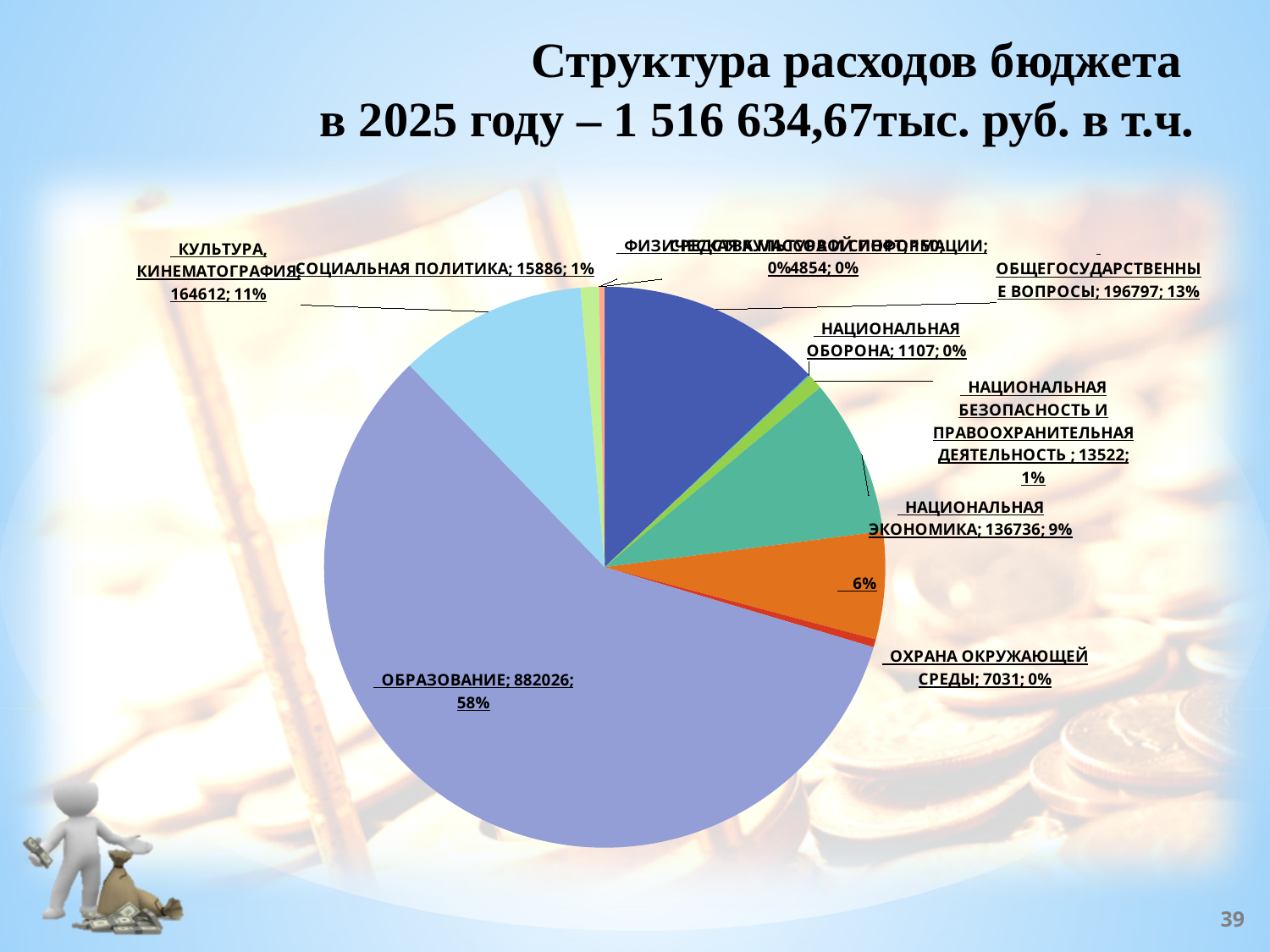
What is the value shown for НАЦИОНАЛЬНАЯ ОБОРОНА? 1107 What is the difference between the values for КУЛЬТУРА, КИНЕМАТОГРАФИЯ and НАЦИОНАЛЬНАЯ ЭКОНОМИКА? 27876 What share of the pie does ОБРАЗОВАНИЕ account for? 58% Which category has the largest slice of the pie? ОБРАЗОВАНИЕ What kind of chart is shown on the slide? Pie chart What is the value shown for ОБЩЕГОСУДАРСТВЕННЫЕ ВОПРОСЫ? 196797 What percentage of the pie is КУЛЬТУРА, КИНЕМАТОГРАФИЯ? 11% What is the difference between the values for ОБЩЕГОСУДАРСТВЕННЫЕ ВОПРОСЫ and НАЦИОНАЛЬНАЯ ЭКОНОМИКА? 60061 Which is larger, ОБЩЕГОСУДАРСТВЕННЫЕ ВОПРОСЫ or НАЦИОНАЛЬНАЯ ЭКОНОМИКА? ОБЩЕГОСУДАРСТВЕННЫЕ ВОПРОСЫ What is the value shown for НАЦИОНАЛЬНАЯ ЭКОНОМИКА? 136736 What total budget expenditure for 2025 is stated in the slide title? 1 516 634,67 тыс. руб. What is the value shown for ОБРАЗОВАНИЕ in the pie chart? 882026